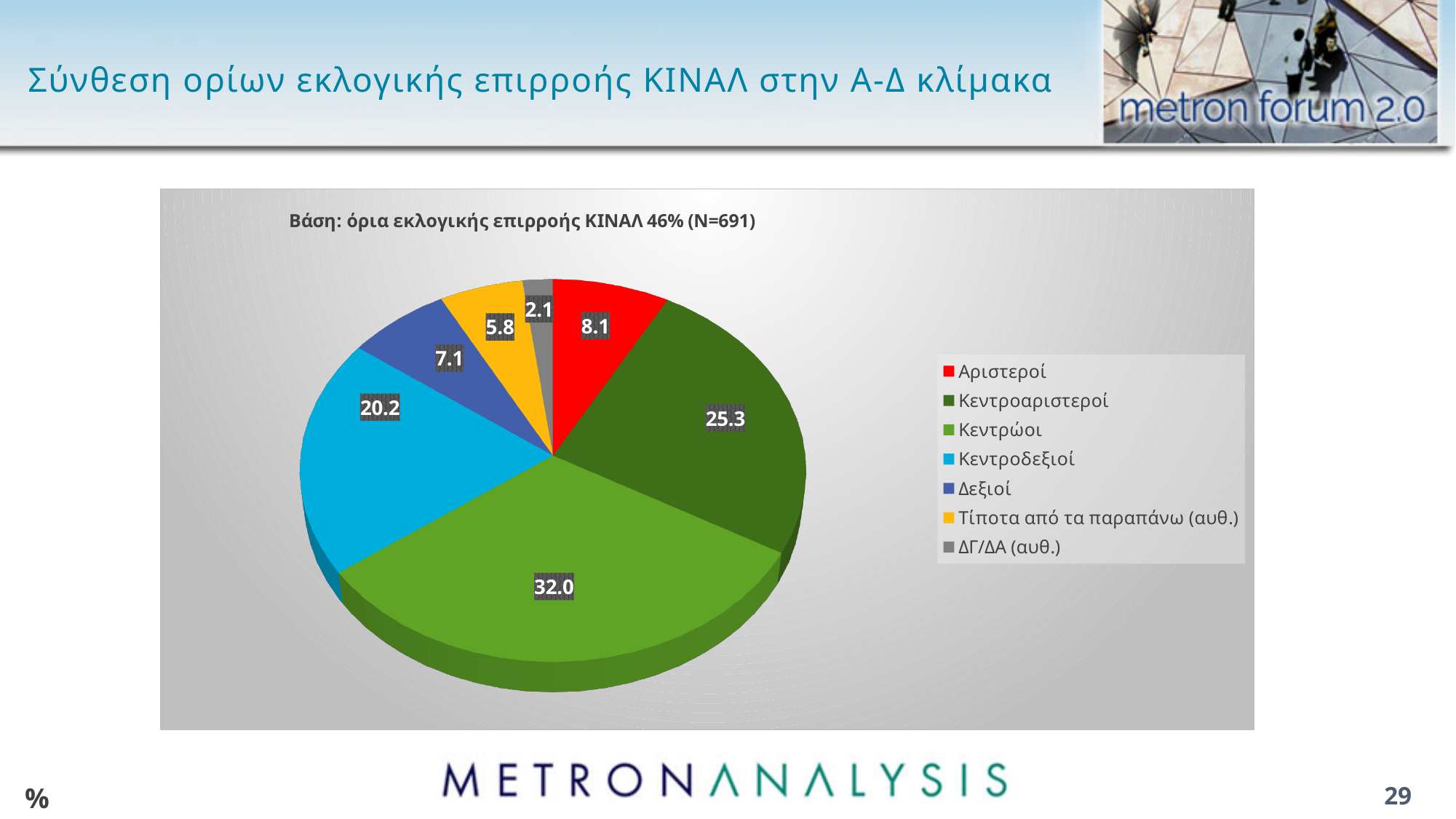
Which category has the largest slice? Κεντρώοι What is the value for Κεντροδεξιοί? 20.2 What is the difference between the values for Κεντρώοι and Κεντροαριστεροί? 6.7 Which is larger, the value for Δεξιοί or the value for Τίποτα από τα παραπάνω (αυθ.)? Δεξιοί What is the sample size (N) stated in the chart's base note? 691 What type of chart is shown on the slide? pie chart What is the value for Αριστεροί? 8.1 What is the value for Κεντρώοι? 32.0 What is the value for ΔΓ/ΔΑ (αυθ.)? 2.1 What is the value for Κεντροαριστεροί? 25.3 Which category has the smallest slice? ΔΓ/ΔΑ (αυθ.) How many categories does the legend list? 7